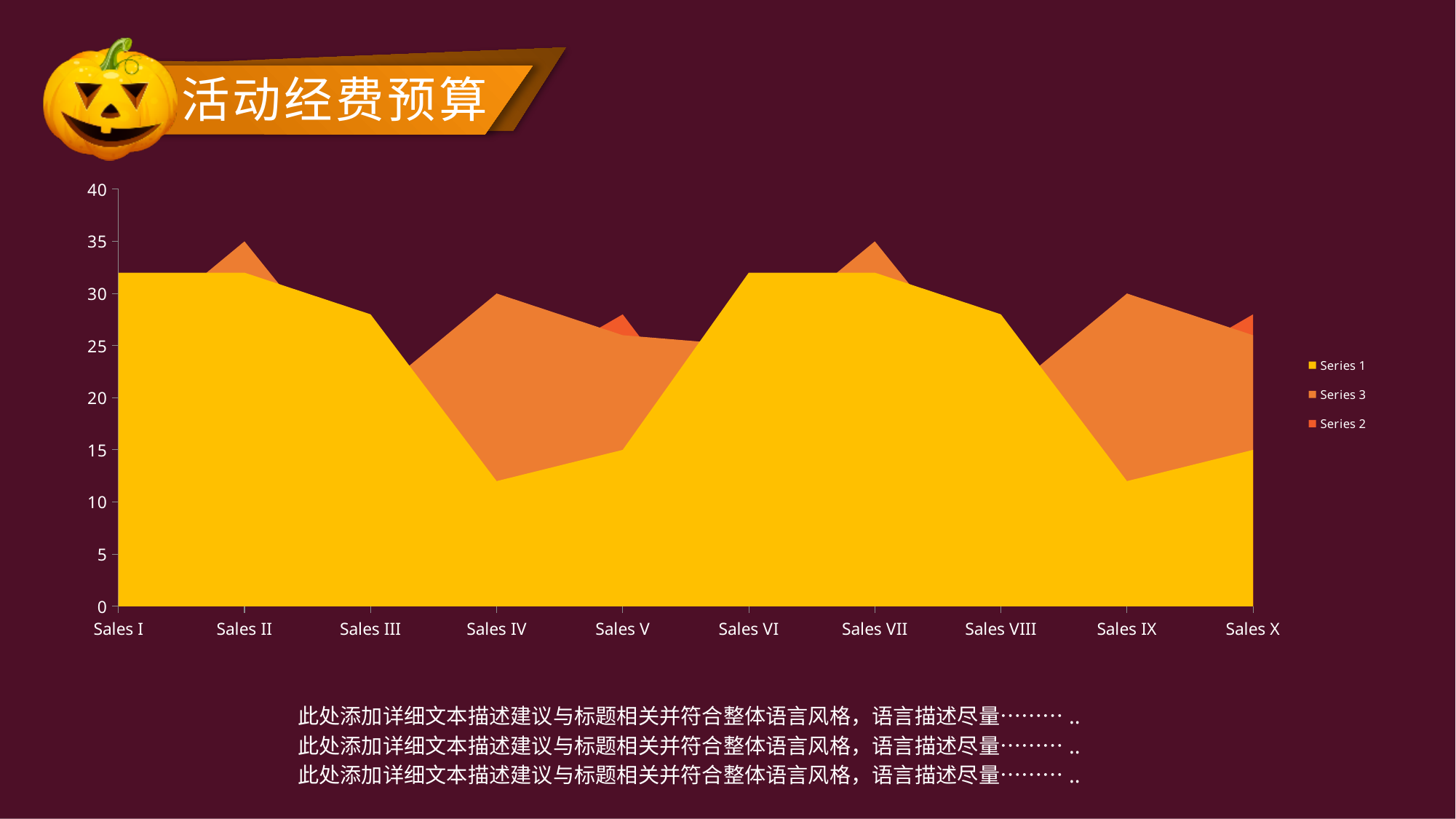
What is the title of the slide containing the chart? 活动经费预算 Does the value of Series 1 rise or fall from Sales II to Sales IV? fall What kind of chart is shown on the slide? area chart Is the value of Series 1 for Sales IV greater or less than 15? less Is the value of Series 1 for Sales I greater or less than 30? greater Is the value of Series 3 for Sales IV greater or less than 25? greater How many categories are shown along the x axis? 10 For Series 1, which is larger: the value for Sales III or the value for Sales V? Sales III How many series does the legend list? 3 For Series 1, which is larger: the value for Sales I or the value for Sales IV? Sales I